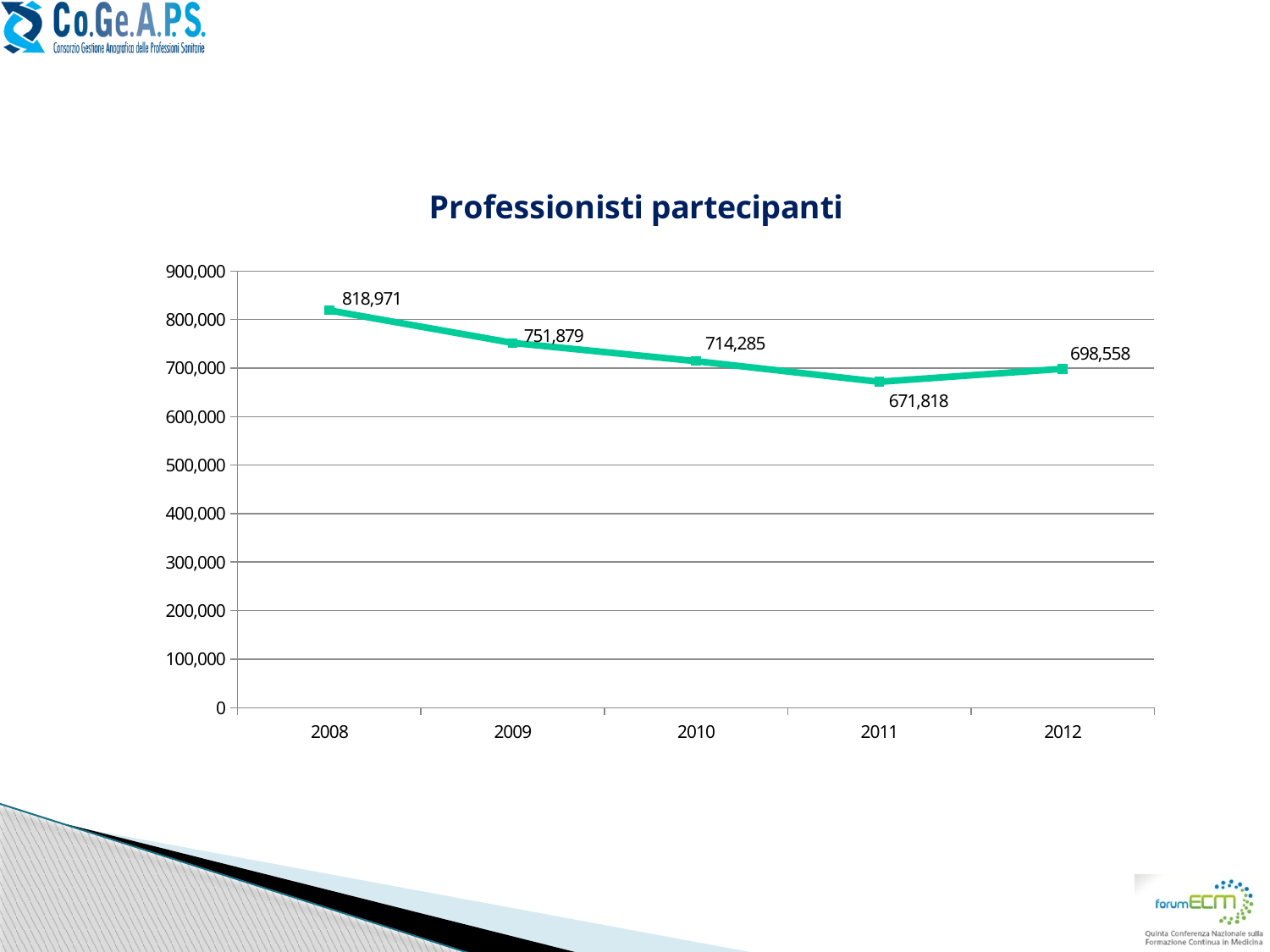
What is the value for 2012? 698,558 What is the value for 2008? 818,971 Is the value for 2011 greater or less than 700,000? less What is the difference between the values for 2012 and 2011? 26,740 Which is larger, the value for 2010 or the value for 2012? 2010 Which year has the highest value? 2008 What is the difference between the values for 2008 and 2009? 67,092 What is the value for 2011? 671,818 What is the title of the chart? Professionisti partecipanti What kind of chart is shown? line chart How many years are plotted on the chart? 5 Which year has the lowest value? 2011